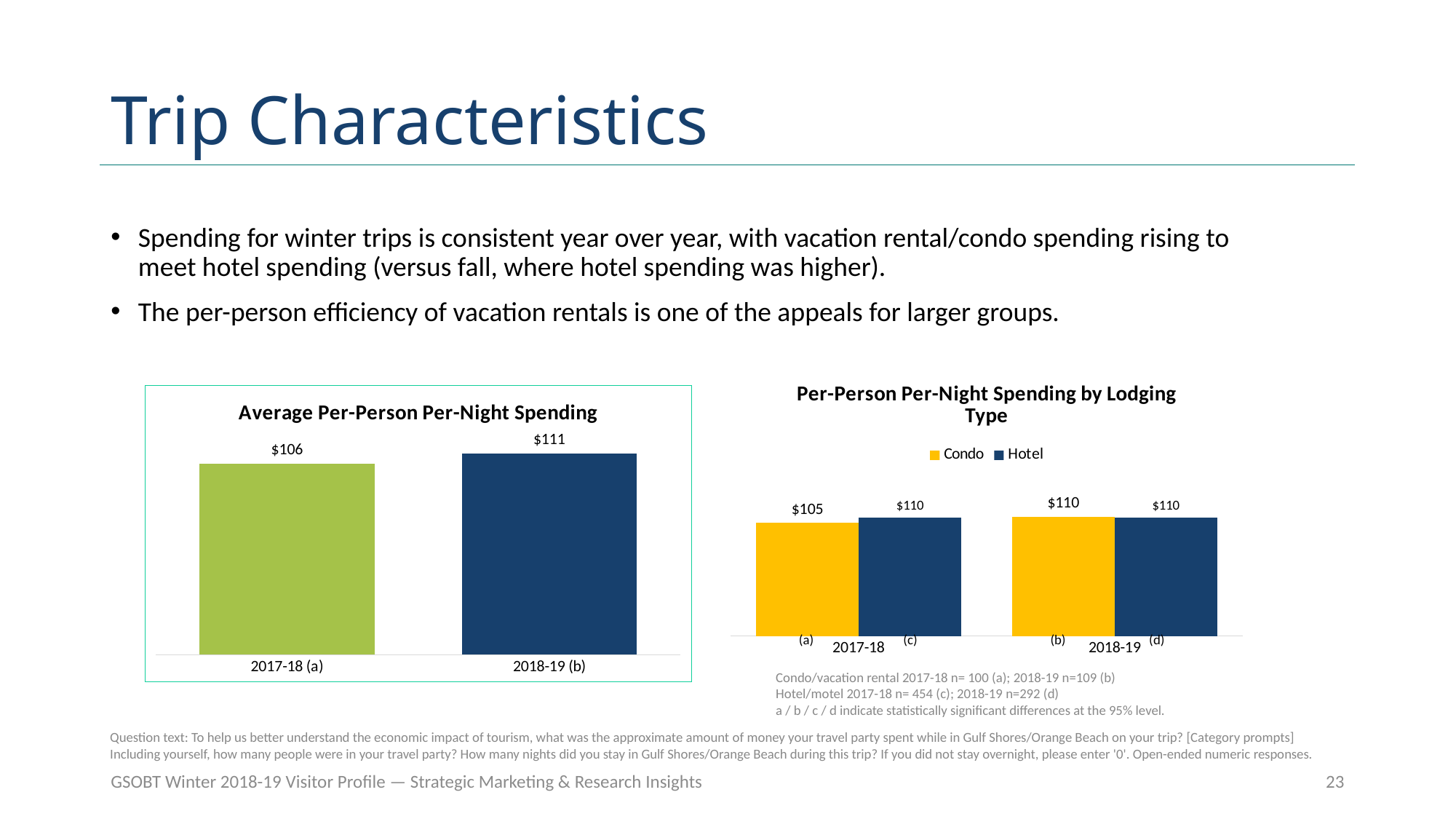
In the 'Per-Person Per-Night Spending by Lodging Type' chart, what is the Condo value for 2017-18? $105 In the 'Per-Person Per-Night Spending by Lodging Type' chart, what is the difference between the Hotel and Condo values for 2017-18? $5 What kind of chart is the 'Average Per-Person Per-Night Spending' chart? Bar chart In the 'Per-Person Per-Night Spending by Lodging Type' chart, how many series does the legend list? 2 In the 'Per-Person Per-Night Spending by Lodging Type' chart, which colour represents the Condo series? Yellow In the 'Average Per-Person Per-Night Spending' chart, what is the difference between the 2018-19 (b) and 2017-18 (a) values? $5 In the 'Per-Person Per-Night Spending by Lodging Type' chart, what is the Hotel value for 2018-19? $110 In the 'Average Per-Person Per-Night Spending' chart, what is the value for 2017-18 (a)? $106 In the 'Average Per-Person Per-Night Spending' chart, how many categories are shown? 2 In the 'Average Per-Person Per-Night Spending' chart, what is the value for 2018-19 (b)? $111 In the 'Per-Person Per-Night Spending by Lodging Type' chart, does the Condo value rise or fall from 2017-18 to 2018-19? Rise In the 'Average Per-Person Per-Night Spending' chart, which year has the higher value? 2018-19 (b)